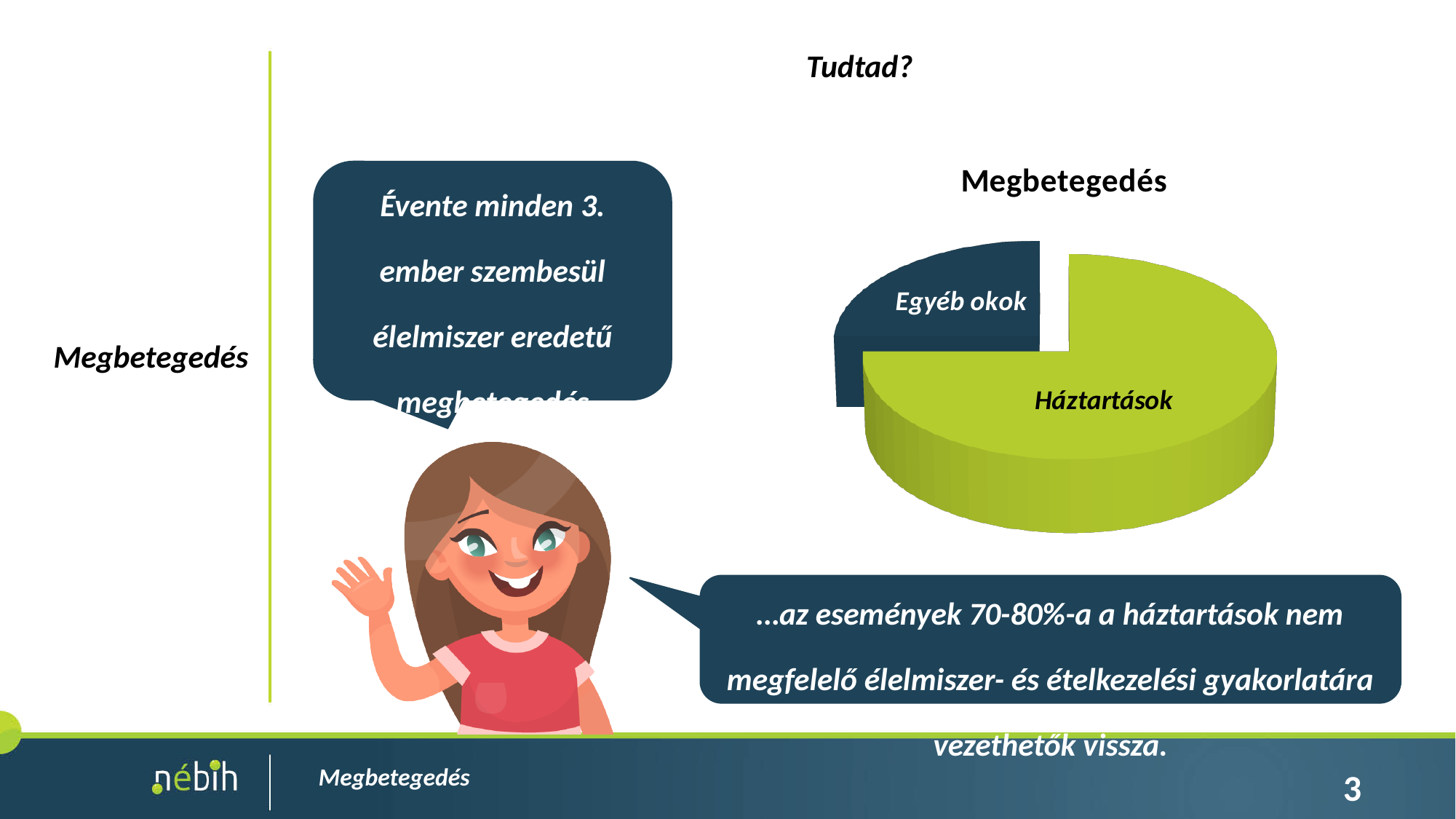
What is the title of the pie chart? Megbetegedés Which slice of the pie chart is the smallest? Egyéb okok What colour is the Háztartások slice in the pie chart? Green What kind of chart is shown on the slide? Pie chart Does the Háztartások slice take up more or less than half of the pie chart? More How many slices does the pie chart have? 2 Which slice is larger in the pie chart, Háztartások or Egyéb okok? Háztartások Which slice of the pie chart is the largest? Háztartások